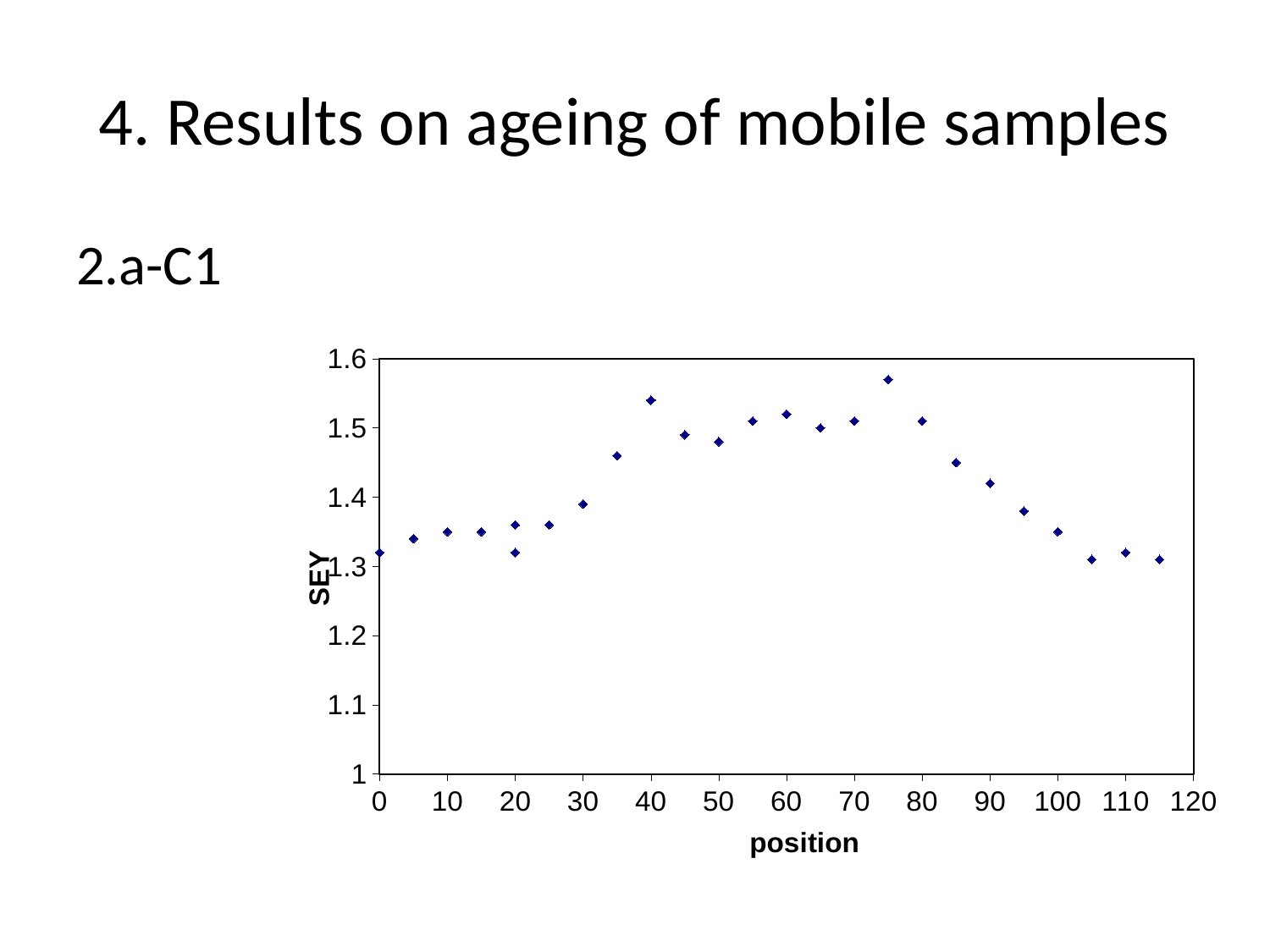
What kind of chart is shown on the slide? scatter chart Which has the larger SEY value, position 40 or position 100? position 40 At which position is the SEY value highest? 75 Is the SEY value at position 60 greater or less than 1.5? greater What is the label of the horizontal axis? position Is the SEY value at position 100 greater or less than 1.4? less How does SEY change as position increases from 75 to 115? it falls Is the SEY value at position 40 greater or less than 1.5? greater What is the label of the vertical axis? SEY Which has the larger SEY value, position 75 or position 0? position 75